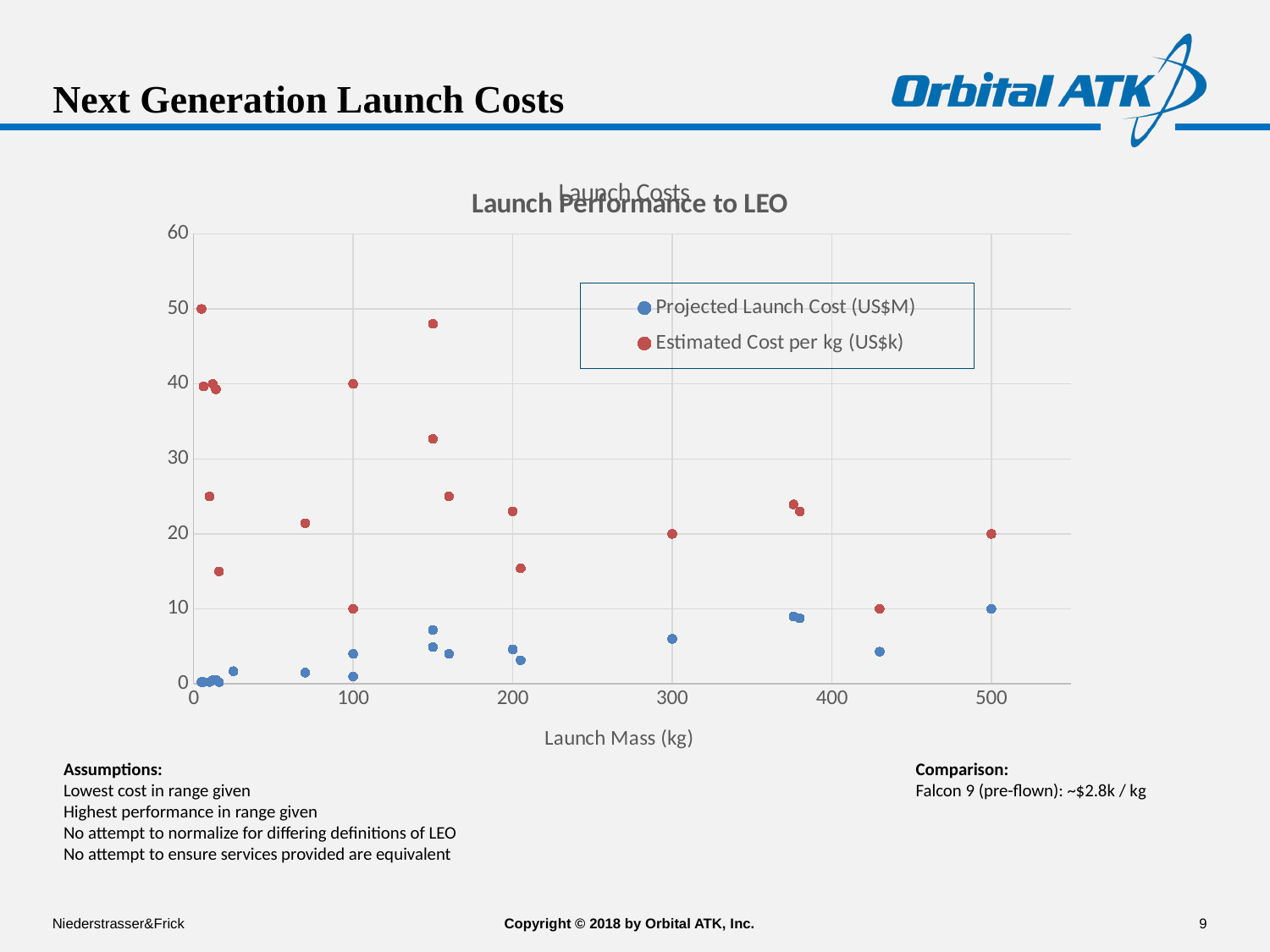
Is the Projected Launch Cost for the launcher at 500 kg launch mass greater or less than 20? less Is the Projected Launch Cost for the launcher at 300 kg launch mass greater or less than 10? less What is the title of the chart's horizontal axis? Launch Mass (kg) What are the two series named in the chart legend? Projected Launch Cost (US$M) and Estimated Cost per kg (US$k) What kind of chart is shown on the slide? Scatter chart At 500 kg launch mass, which series has the higher plotted value: Projected Launch Cost (US$M) or Estimated Cost per kg (US$k)? Estimated Cost per kg (US$k) Is the Estimated Cost per kg for the launcher at 300 kg launch mass greater or less than 10? greater Does the Projected Launch Cost generally rise or fall as launch mass increases along the x axis? Rise At 300 kg launch mass, which series has the higher plotted value: Projected Launch Cost (US$M) or Estimated Cost per kg (US$k)? Estimated Cost per kg (US$k) How many series does the chart legend list? 2